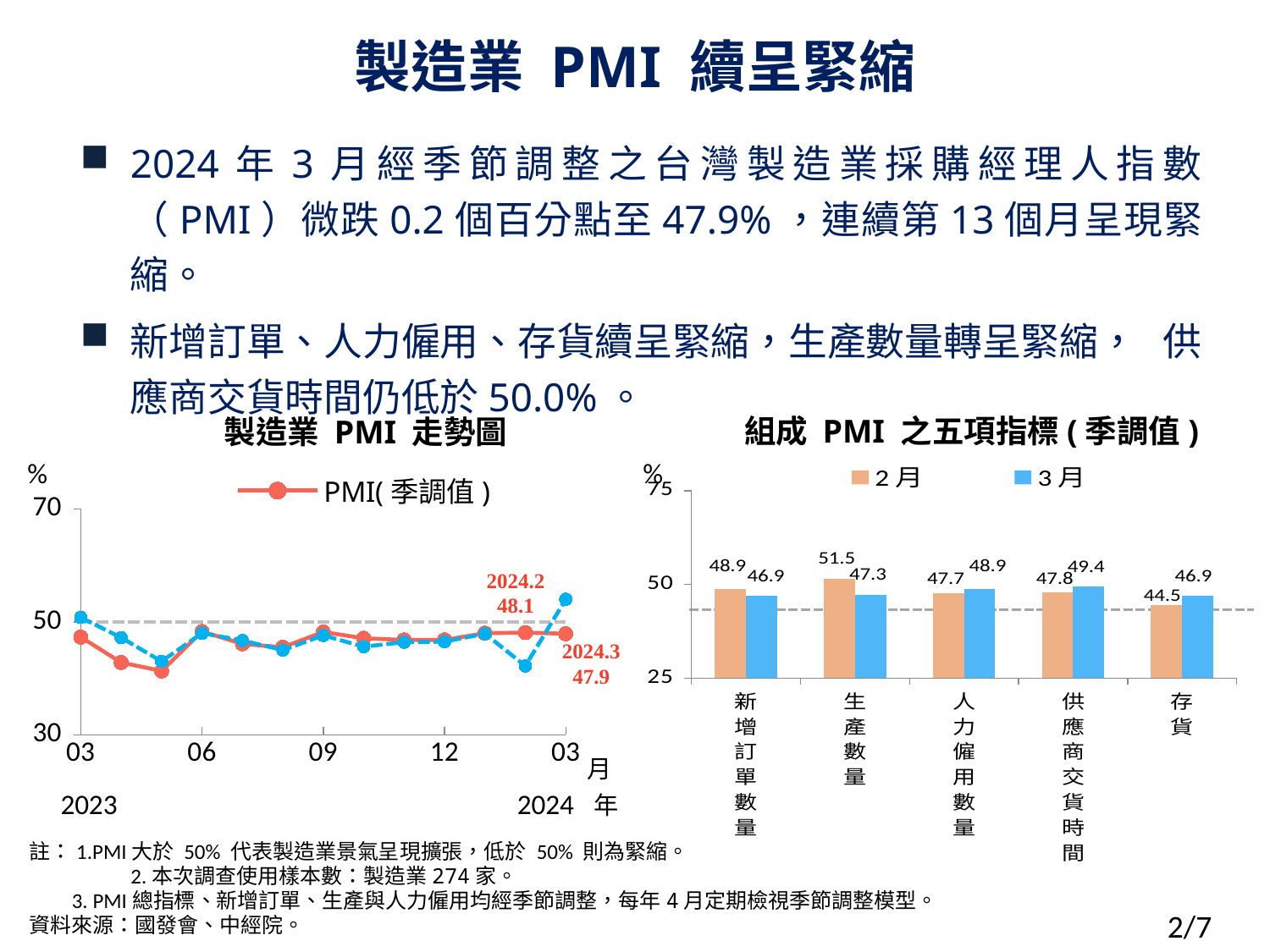
In the chart titled 製造業 PMI 走勢圖, what is the difference between the labelled values for 2024.2 and 2024.3? 0.2 In the chart titled 製造業 PMI 走勢圖, what is the PMI(季調值) value labelled for 2024.3? 47.9 In the chart titled 組成 PMI 之五項指標(季調值), which category has the highest 2月 value? 生產數量 In the chart titled 組成 PMI 之五項指標(季調值), how many series does the legend list? 2 In the chart titled 組成 PMI 之五項指標(季調值), which category has the highest 3月 value? 供應商交貨時間 In the chart titled 組成 PMI 之五項指標(季調值), what is the 3月 value for 生產數量? 47.3 In the chart titled 組成 PMI 之五項指標(季調值), which category has the lowest 2月 value? 存貨 In the chart titled 組成 PMI 之五項指標(季調值), how many categories are shown on the x axis? 5 In the chart titled 組成 PMI 之五項指標(季調值), what is the difference between the 2月 and 3月 values for 生產數量? 4.2 In the chart titled 組成 PMI 之五項指標(季調值), what is the 2月 value for 存貨? 44.5 What kind of chart is the chart titled 組成 PMI 之五項指標(季調值)? bar chart In the chart titled 組成 PMI 之五項指標(季調值), is the 2月 or the 3月 value larger for 供應商交貨時間? 3月